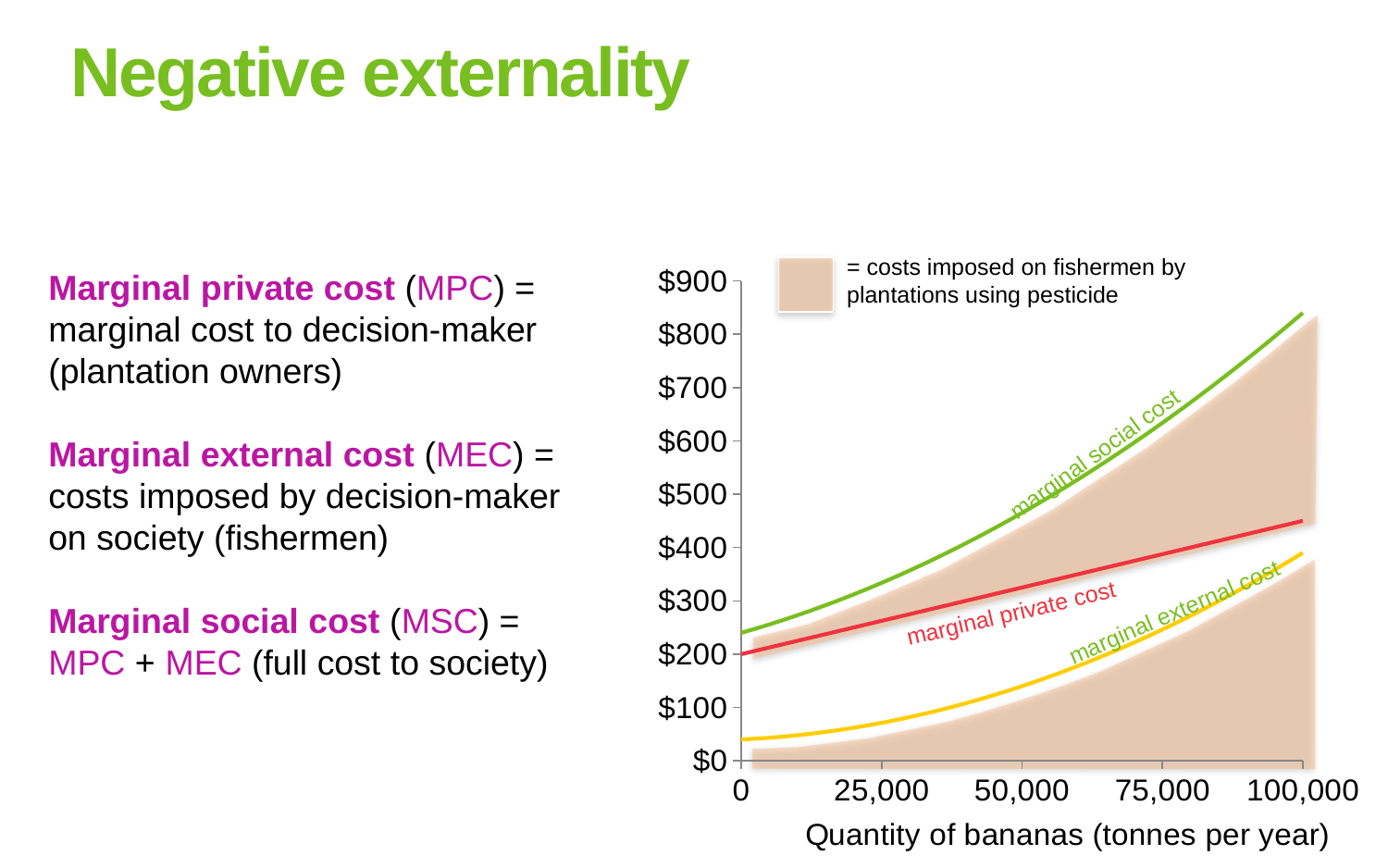
Which curve is highest at a quantity of 100,000 tonnes per year? marginal social cost Is the marginal private cost at 100,000 tonnes greater or less than $500? less Which curve is lowest at a quantity of 0? marginal external cost What kind of chart is shown on the slide? line chart Do the cost curves rise or fall as the quantity of bananas increases? rise How many cost curves are plotted on the chart? 3 At 50,000 tonnes, which is larger: marginal social cost or marginal private cost? marginal social cost Is the marginal social cost at 100,000 tonnes greater or less than $800? greater According to the legend, what does the shaded area represent? costs imposed on fishermen by plantations using pesticide What is the label of the x axis? Quantity of bananas (tonnes per year) Is the marginal private cost at a quantity of 0 greater or less than $100? greater